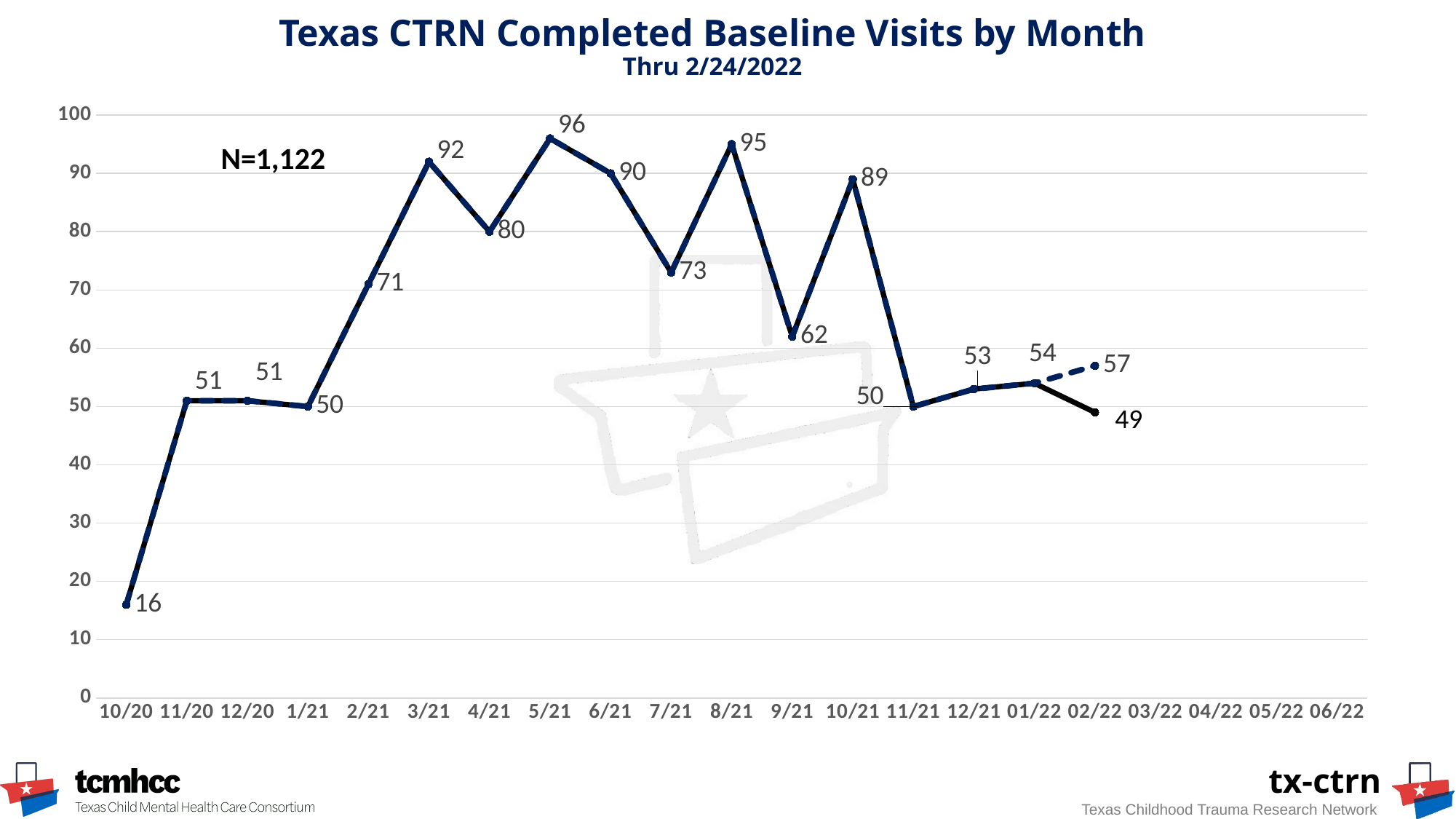
What is the title of the chart? Texas CTRN Completed Baseline Visits by Month What is the value for 3/21? 92 Which month has the highest value? 5/21 Do the values rise or fall from 10/20 to 11/20? rise What kind of chart is shown on the slide? line chart Which month has the lowest value? 10/20 Is the value for 2/21 greater or less than 70? greater What is the difference between the values for 8/21 and 7/21? 22 What is the value for 10/20? 16 Which is larger, the value for 10/21 or the value for 4/21? 10/21 What N value is printed on the chart? N=1,122 What is the value for 9/21? 62